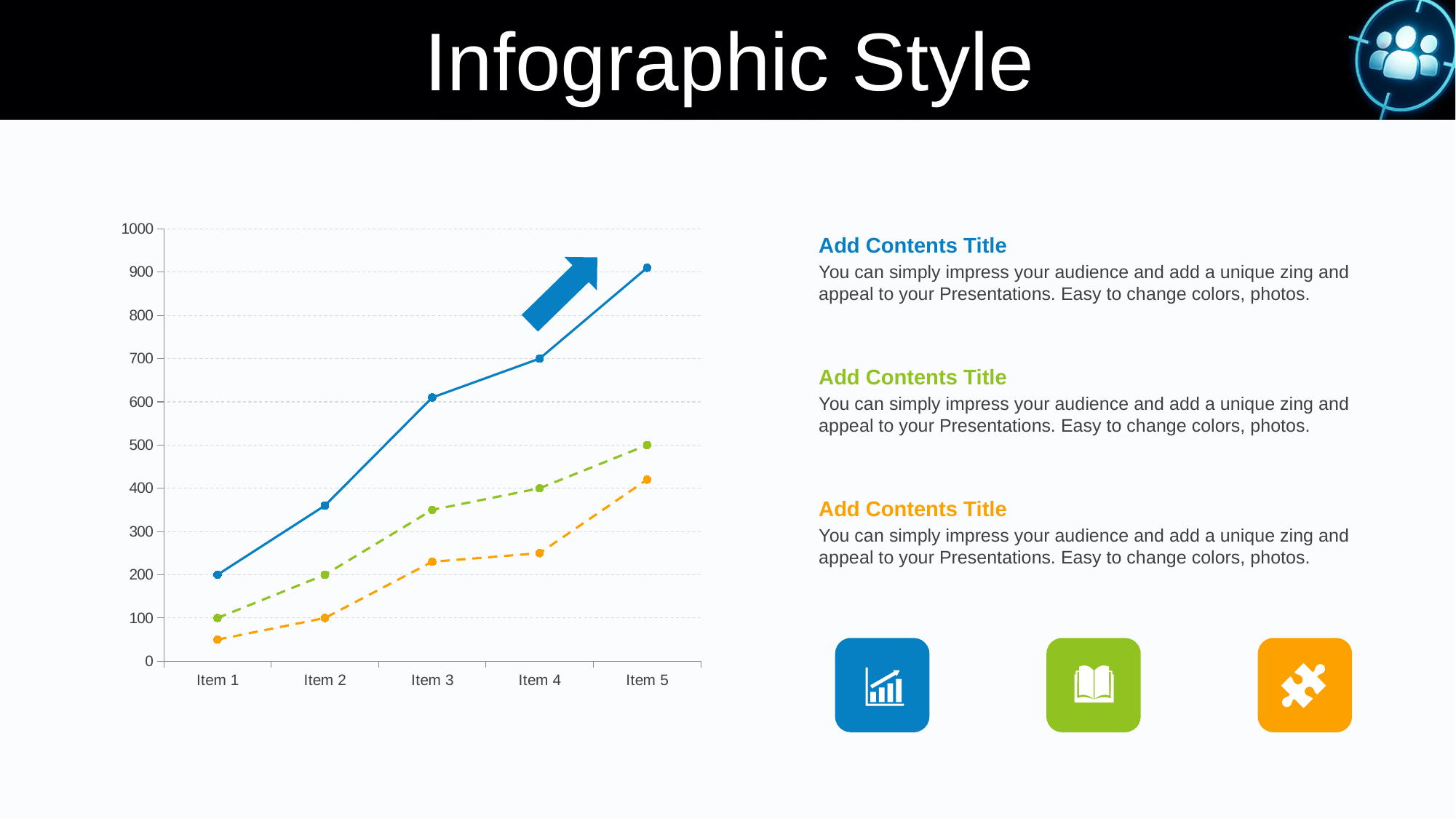
What kind of chart is shown on the slide? line chart At Item 3, is the value of the green dashed line larger or smaller than the value of the orange dashed line? larger What is the value of the green dashed line at Item 4? 400 Is the value of the orange dashed line at Item 1 greater or less than 100? less What is the value of the solid blue line at Item 4? 700 What is the value of the solid blue line at Item 1? 200 Which line has the highest value at Item 5: the solid blue, the green dashed, or the orange dashed line? the solid blue line How many lines are plotted on the chart? 3 Do the values of the solid blue line rise or fall from Item 1 to Item 5? rise How many categories are shown on the x axis of the chart? 5 What is the value of the green dashed line at Item 5? 500